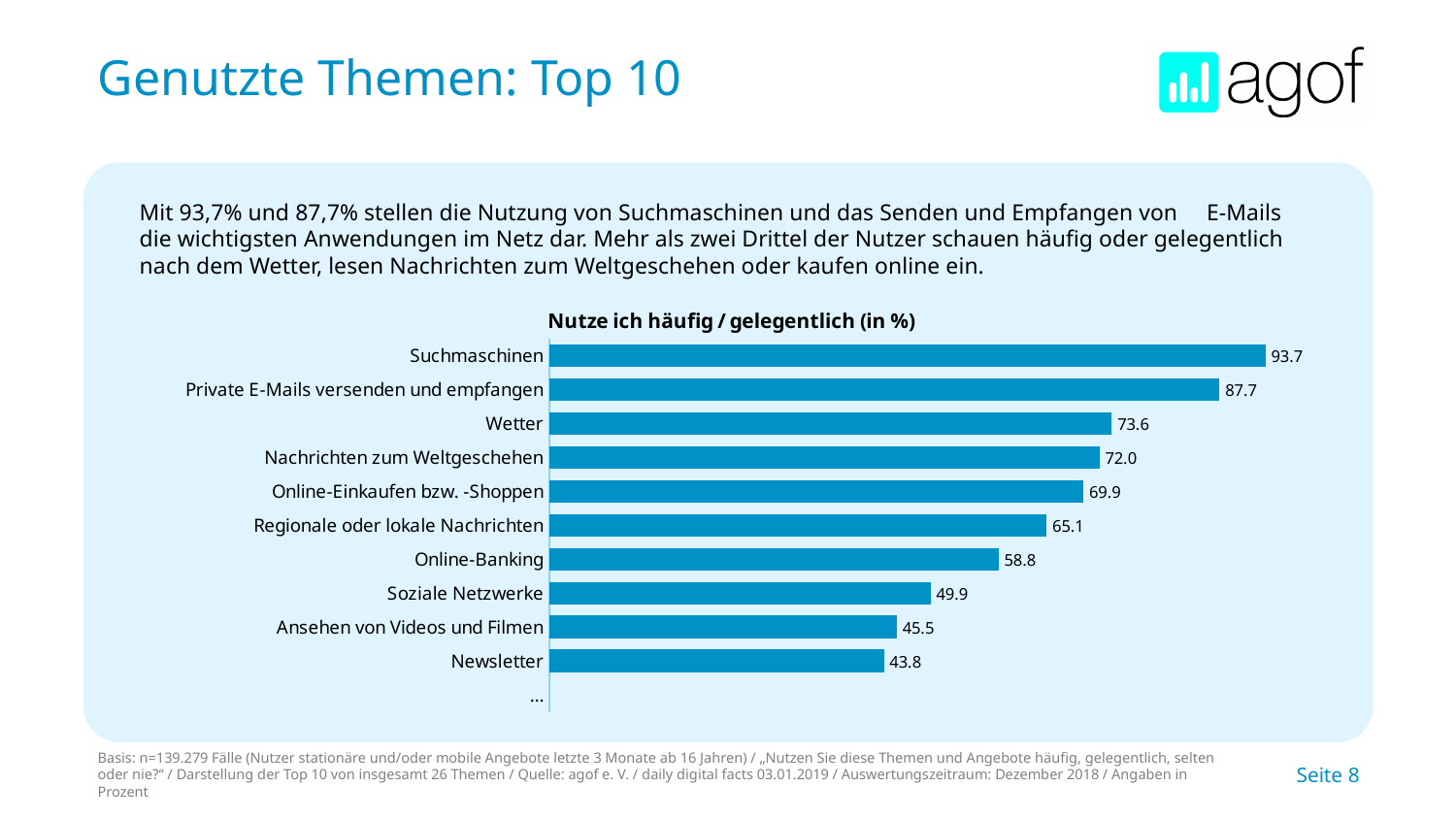
What is the difference between the values for Suchmaschinen and Private E-Mails versenden und empfangen? 6.0 Which is larger, the value for Soziale Netzwerke or the value for Ansehen von Videos und Filmen? Soziale Netzwerke What is the difference between the values for Wetter and Nachrichten zum Weltgeschehen? 1.6 Which category has the highest value? Suchmaschinen What is the value for Newsletter? 43.8 Which labelled category has the lowest value? Newsletter What kind of chart is shown on the slide? bar chart What is the value for Regionale oder lokale Nachrichten? 65.1 How many labelled categories with values are shown in the chart? 10 What is the value for Online-Banking? 58.8 What is the value for Suchmaschinen? 93.7 What is the title of the chart? Nutze ich häufig / gelegentlich (in %)